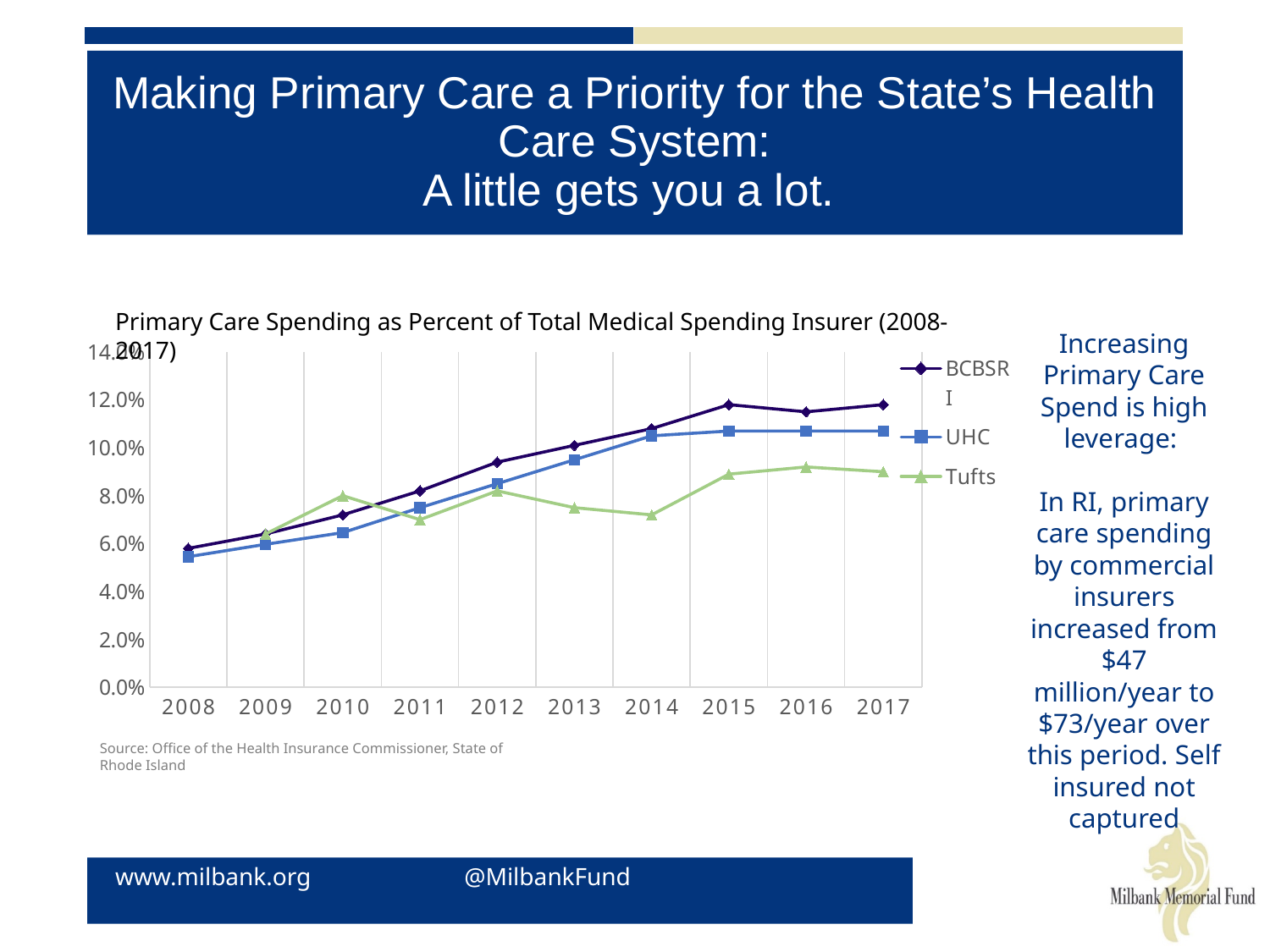
Which insurer has the highest value in 2017? BCBSRI In 2010, which is larger: the value for Tufts or the value for UHC? Tufts Is the value for BCBSRI in 2008 greater or less than 8.0%? less Is the value for BCBSRI in 2017 greater or less than 10.0%? greater How many series does the chart's legend list? 3 Which insurers are listed in the chart's legend? BCBSRI, UHC, Tufts Is the value for Tufts in 2017 greater or less than 10.0%? less How many years are plotted along the x axis of the chart? 10 Which insurer has the lowest value in 2017? Tufts What kind of chart is shown on the slide? Line chart Does the BCBSRI line generally rise or fall from 2008 to 2017? Rise